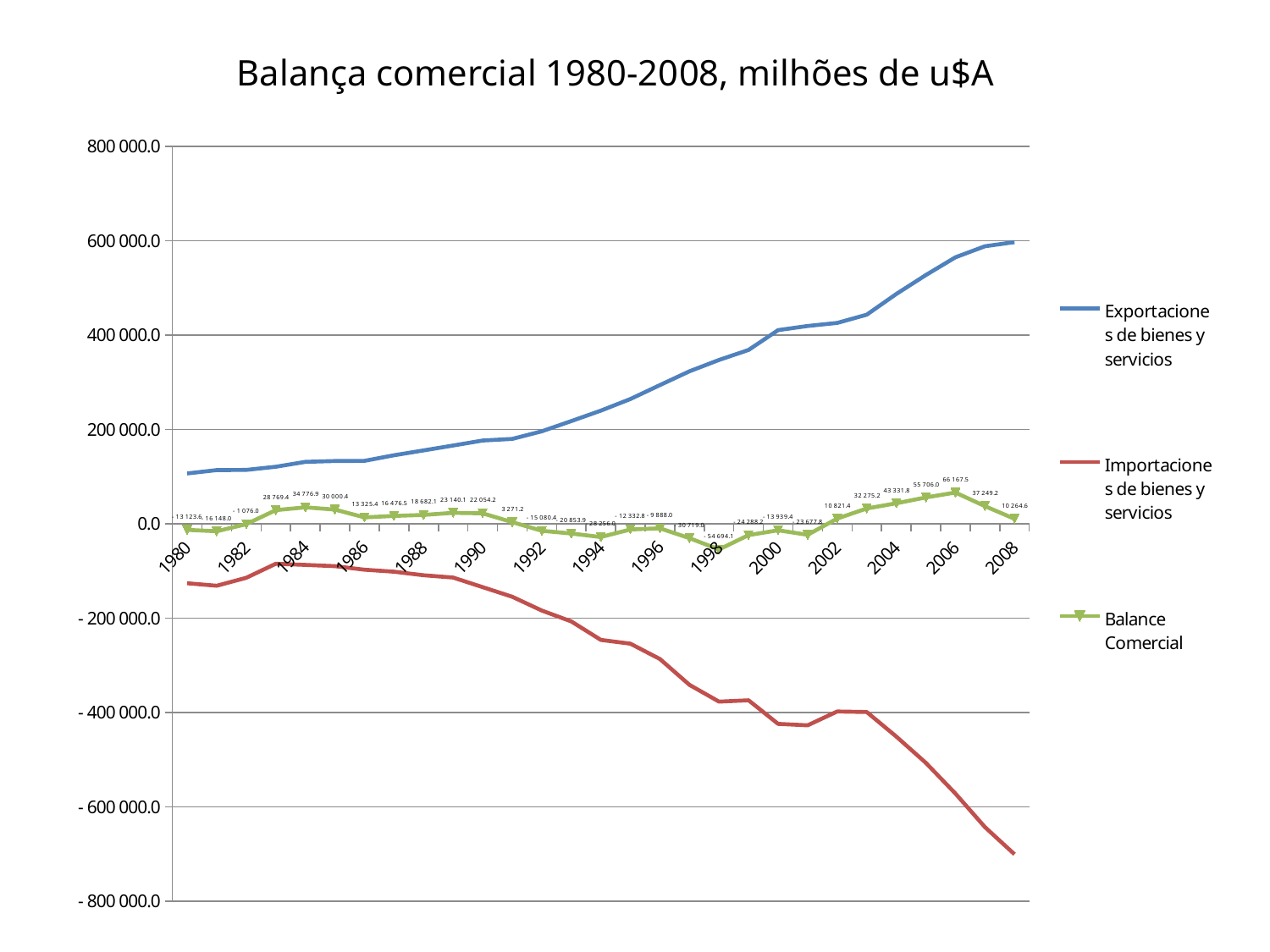
What kind of chart is shown on the slide? line chart What is the title of the chart? Balança comercial 1980-2008, milhões de u$A How many series does the legend list? 3 In which year does the Balance Comercial series reach its lowest value? 1998 What is the Balance Comercial value for 2006? 66 167.5 What is the difference between the Balance Comercial values for 2005 and 2004? 12 374.2 In which year does the Balance Comercial series reach its highest value? 2006 Which is larger for Balance Comercial: the value in 2006 or the value in 2007? 2006 Is the value of Importaciones de bienes y servicios in 2008 greater or less than -600 000.0? less Is the value of Exportaciones de bienes y servicios in 2008 greater or less than 400 000.0? greater What is the Balance Comercial value for 1998? - 54 694.1 Do the values of Exportaciones de bienes y servicios rise or fall from 1980 to 2008? rise